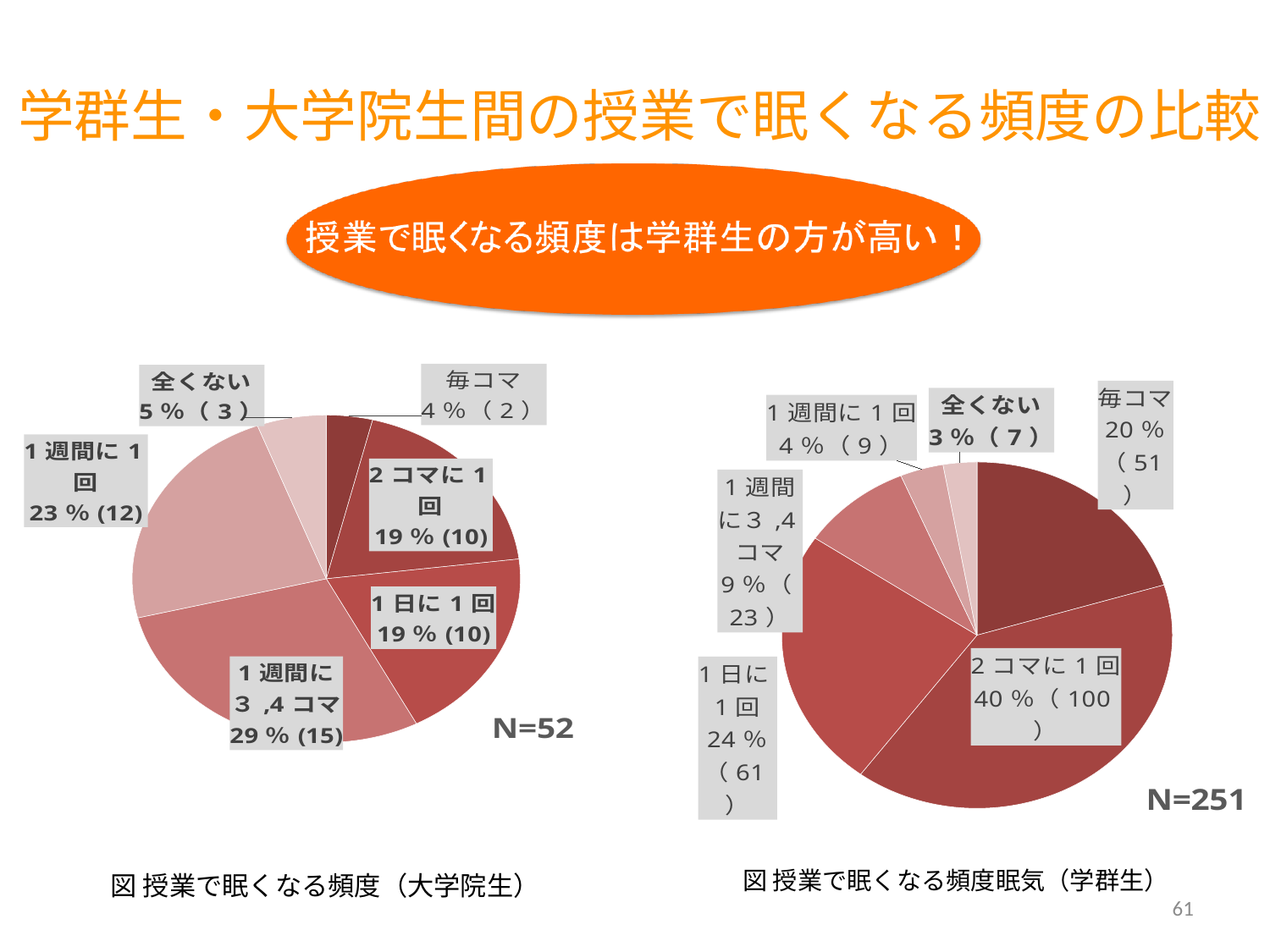
In the right pie chart (学群生), how many respondents answered 毎コマ? 51 In the right pie chart (学群生), which category has the smallest share? 全くない In the left pie chart (大学院生), how many respondents answered 1週間に1回? 12 What is the sample size (N) shown for the left pie chart (大学院生)? N=52 In the left pie chart (大学院生), what percentage is shown for 1週間に3,4コマ? 29% In the left pie chart (大学院生), which category has the largest share? 1週間に3,4コマ What type of chart is used on the left side of the slide (大学院生)? Pie chart How many categories does the right pie chart (学群生) have? 6 In the right pie chart (学群生), what percentage is shown for 2コマに1回? 40% In the right pie chart (学群生), what is the difference in percentage points between 2コマに1回 and 1日に1回? 16 What is the sample size (N) shown for the right pie chart (学群生)? N=251 In the left pie chart (大学院生), which is larger: 1週間に1回 or 全くない? 1週間に1回